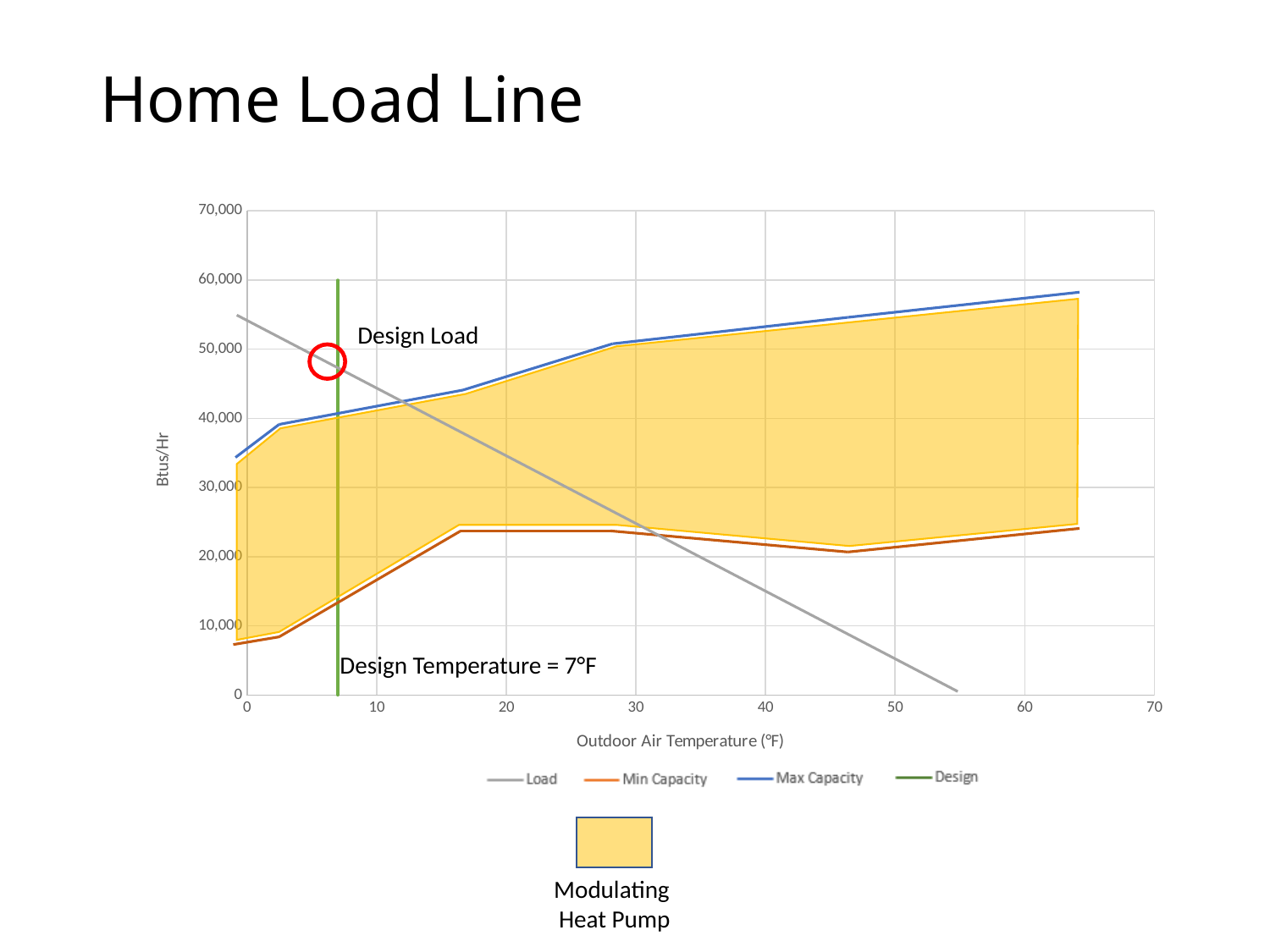
Is the Max Capacity value at 60°F greater or less than 50,000? greater Which series are listed in the chart legend? Load, Min Capacity, Max Capacity, Design Is the Load value at 0°F greater or less than 50,000? greater What is the label on the vertical axis of the chart? Btus/Hr Is the Min Capacity value at 40°F greater or less than 30,000? less What kind of chart is shown on the slide? line chart Does the Load line rise or fall as outdoor air temperature increases? fall At 50°F, which is larger: Min Capacity or Load? Min Capacity At 30°F, which is larger: Max Capacity or Load? Max Capacity How many series does the chart legend list? 4 Does the Max Capacity line rise or fall as outdoor air temperature increases? rise